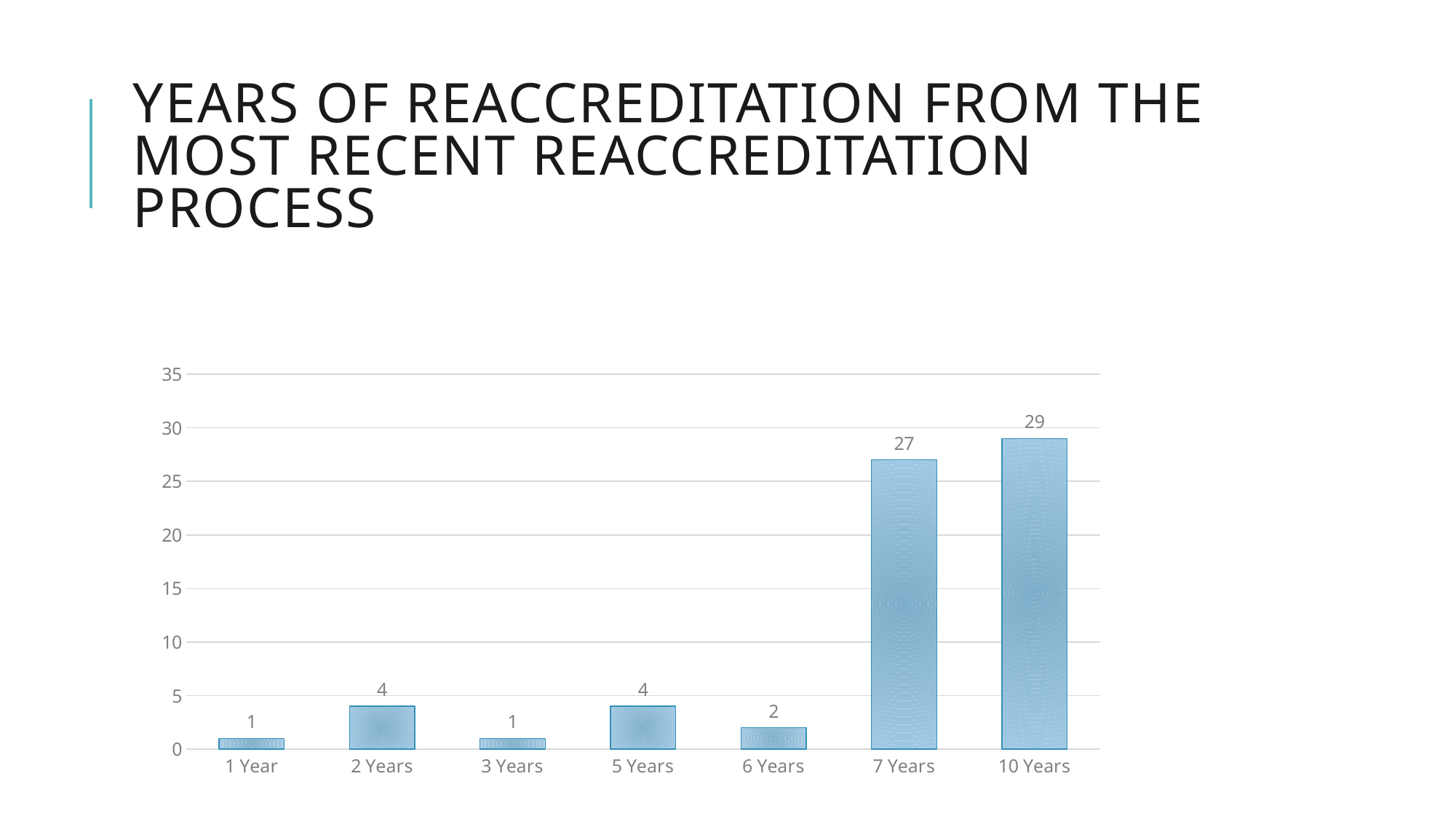
What kind of chart is shown on the slide? bar chart Which is larger, the value for 5 Years or the value for 6 Years? 5 Years Which category has the highest value? 10 Years What is the value for 2 Years? 4 Is the value for 7 Years greater or less than 25? greater What is the value for 7 Years? 27 What is the title of the slide? Years of Reaccreditation from the Most Recent Reaccreditation Process What is the value for 10 Years? 29 What is the difference between the values for 10 Years and 7 Years? 2 What is the value for 6 Years? 2 How many categories are shown on the x axis? 7 What is the total of the values for 1 Year and 3 Years? 2